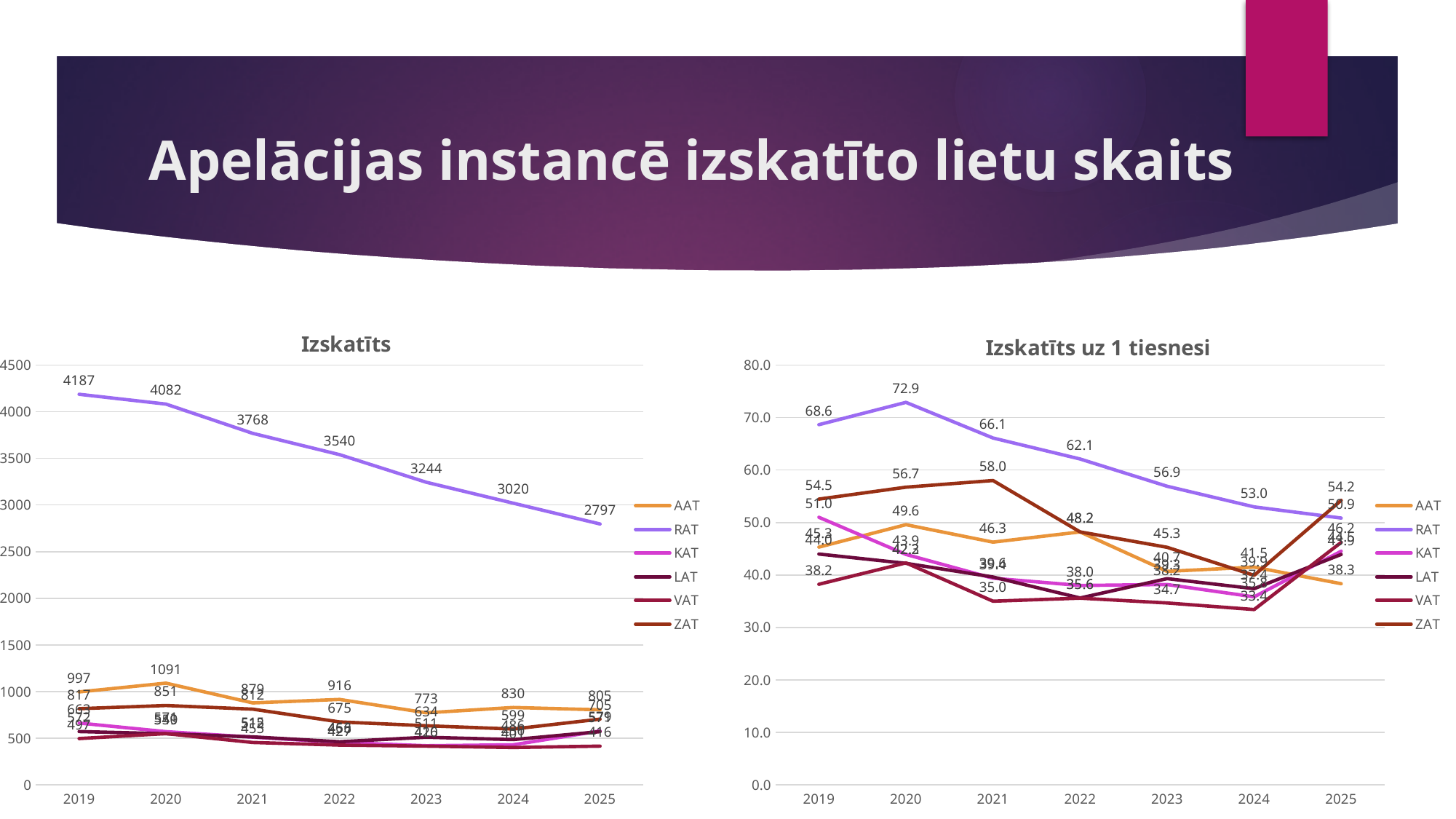
How many years are shown on the x axis of the 'Izskatīts' chart? 7 In the 'Izskatīts' chart, what is the difference between the RAT values for 2019 and 2025? 1390 In the 'Izskatīts uz 1 tiesnesi' chart, in which year is the RAT value highest? 2020 In the 'Izskatīts' chart, does the RAT series rise or fall from 2019 to 2025? fall In the 'Izskatīts' chart, in which year is the AAT value highest? 2020 In the 'Izskatīts' chart, what is the RAT value for 2019? 4187 In the 'Izskatīts uz 1 tiesnesi' chart, what is the RAT value for 2020? 72.9 What kind of chart is the 'Izskatīts' chart on the left? line chart In the 'Izskatīts uz 1 tiesnesi' chart, which is larger in 2021, RAT or AAT? RAT In the 'Izskatīts uz 1 tiesnesi' chart, what is the ZAT value for 2021? 58.0 In the 'Izskatīts' chart, what is the RAT value for 2025? 2797 How many series does the legend of the 'Izskatīts' chart list? 6